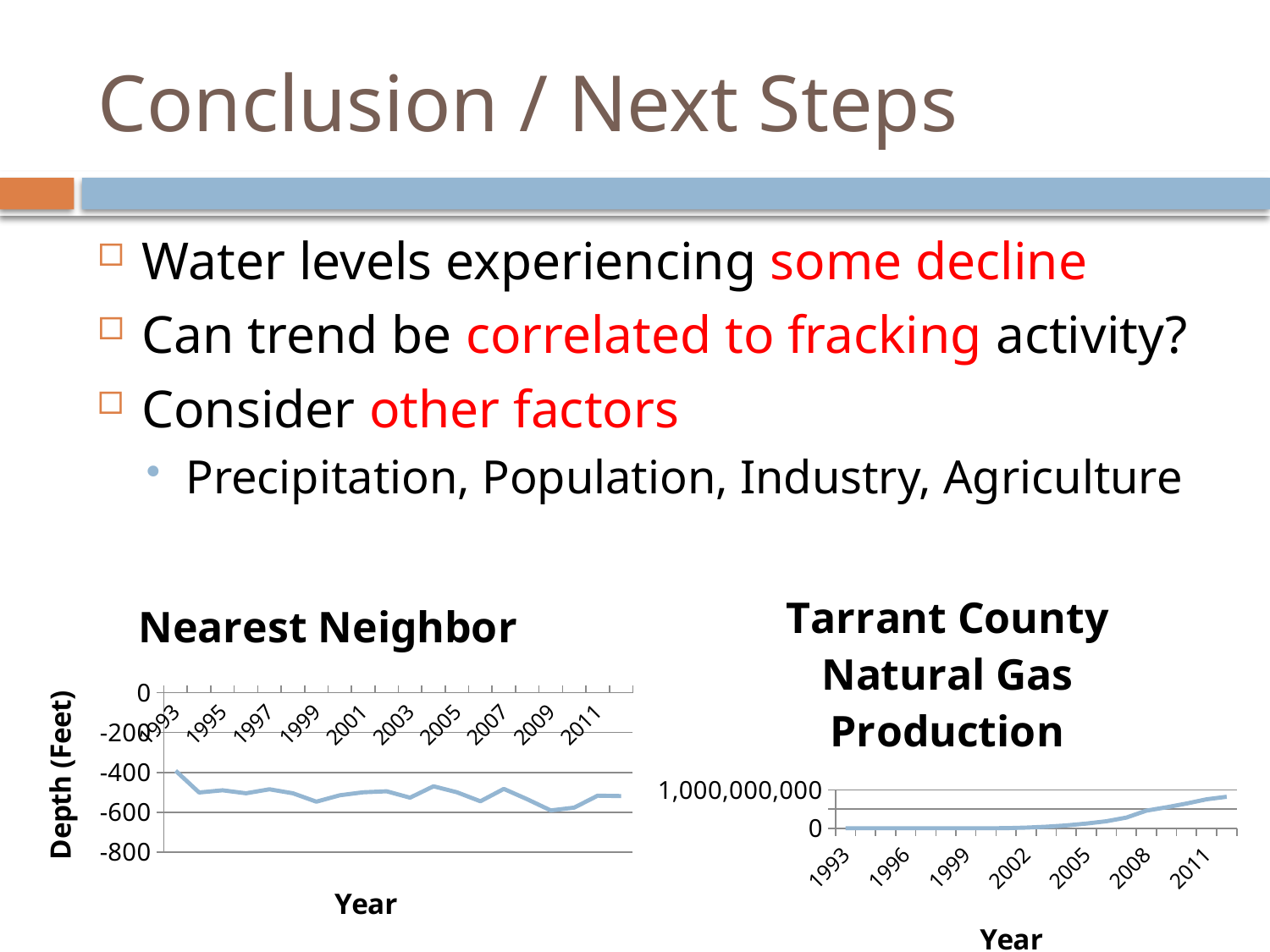
In the "Nearest Neighbor" chart, which year has the higher depth value, 1993 or 2009? 1993 In the "Tarrant County Natural Gas Production" chart, what is the label of the horizontal axis? Year In the "Nearest Neighbor" chart, do the depth values generally rise or fall from 1993 to 2011? fall In the "Nearest Neighbor" chart, is the depth value for 2005 greater or less than -600? greater In the "Nearest Neighbor" chart, is the depth value for 2011 greater or less than -600? greater What kind of chart is the "Nearest Neighbor" chart? line chart How many year labels are shown on the x axis of the "Tarrant County Natural Gas Production" chart? 7 In the "Nearest Neighbor" chart, what is the label of the vertical axis? Depth (Feet) In the "Tarrant County Natural Gas Production" chart, is the value for 1996 greater or less than 1,000,000,000? less What kind of chart is the "Tarrant County Natural Gas Production" chart? line chart In the "Tarrant County Natural Gas Production" chart, do the values rise or fall from 1993 to 2011? rise